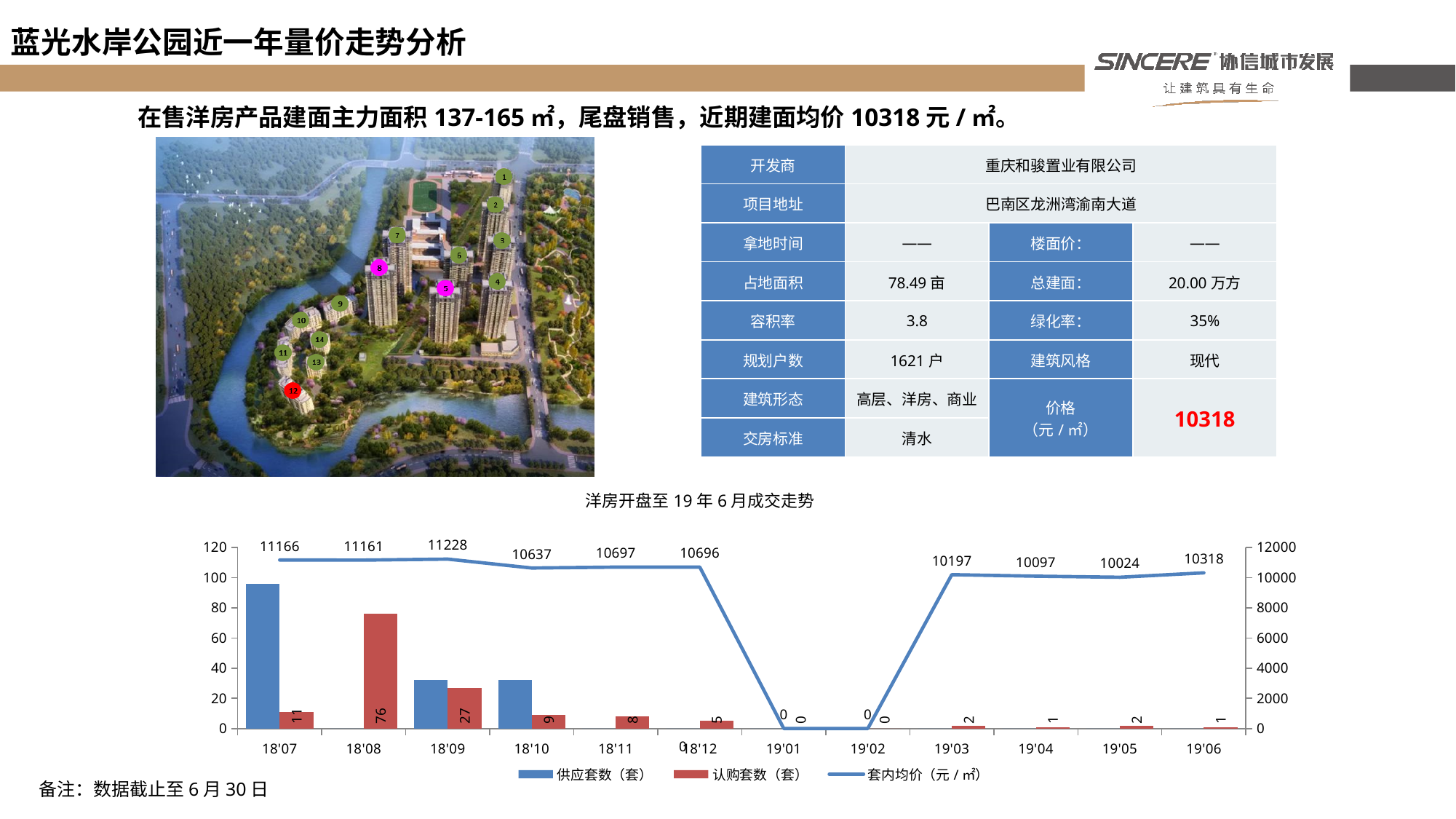
Which month has the highest 套内均价? 18'09 What is the 套内均价 value for 19'06? 10318 What is the 认购套数 value for 19'04? 1 What is the 认购套数 value for 18'08? 76 Is the 供应套数 value for 18'07 greater or less than 80? greater Which is larger, the 套内均价 for 18'10 or for 18'11? 18'11 What type of chart is shown under the title 洋房开盘至19年6月成交走势? Combination bar and line chart What is the 套内均价 value for 18'09? 11228 What is the difference between the 认购套数 for 18'08 and 18'09? 49 How many months are shown on the x axis of the chart? 12 Which month has the highest 认购套数? 18'08 How many series does the legend of the chart list? 3